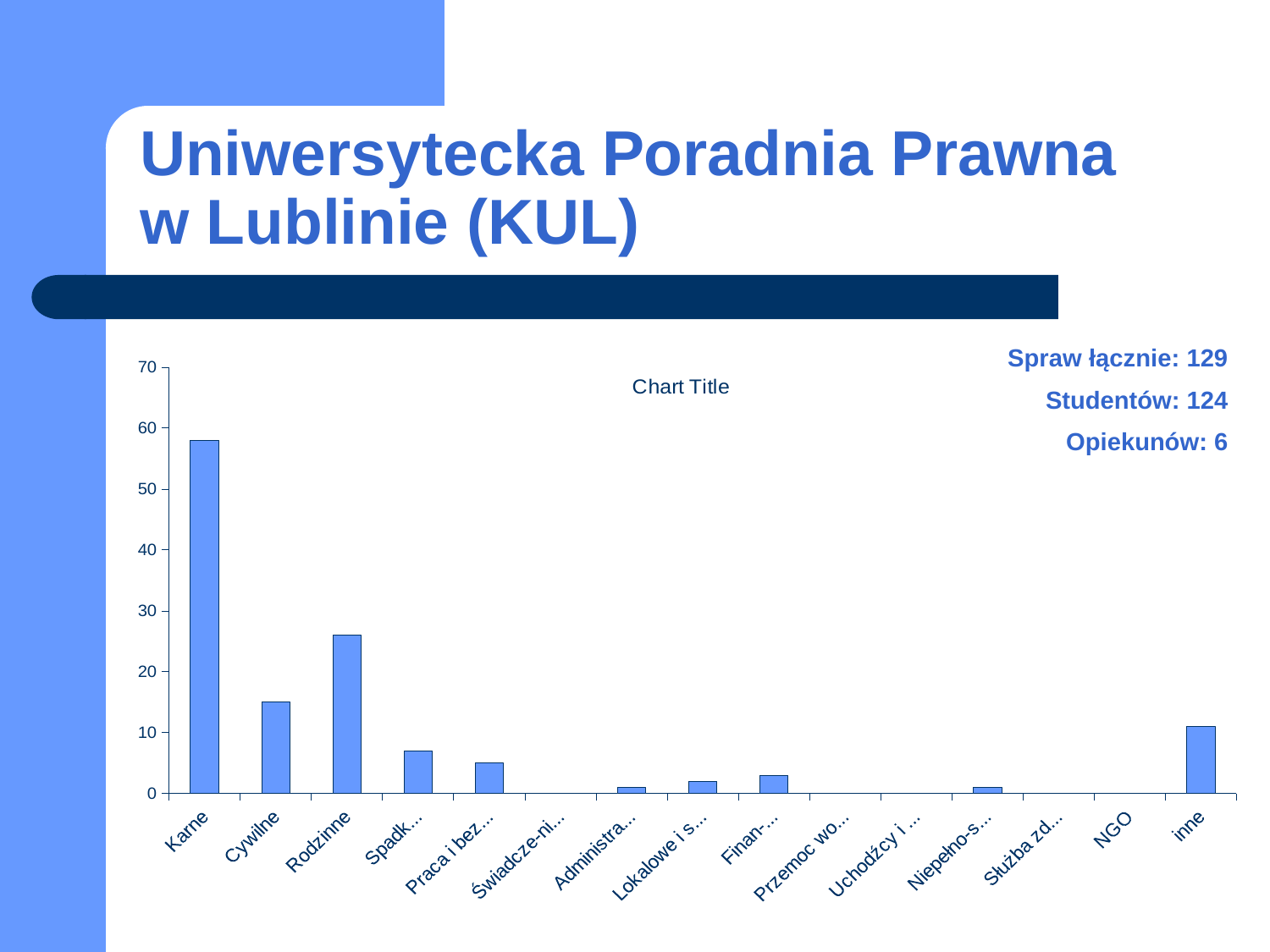
How many categories are shown on the x axis of the chart? 15 Which is larger, the value for Karne or the value for inne? Karne What kind of chart is shown on the slide? bar chart Which is larger, the value for Cywilne or the value for Rodzinne? Rodzinne Is the value for Rodzinne greater or less than 20? greater Is the value for Karne greater or less than 60? less Is the value for Cywilne greater or less than 20? less Which category has the highest bar in the chart? Karne What is the title shown on the chart? Chart Title